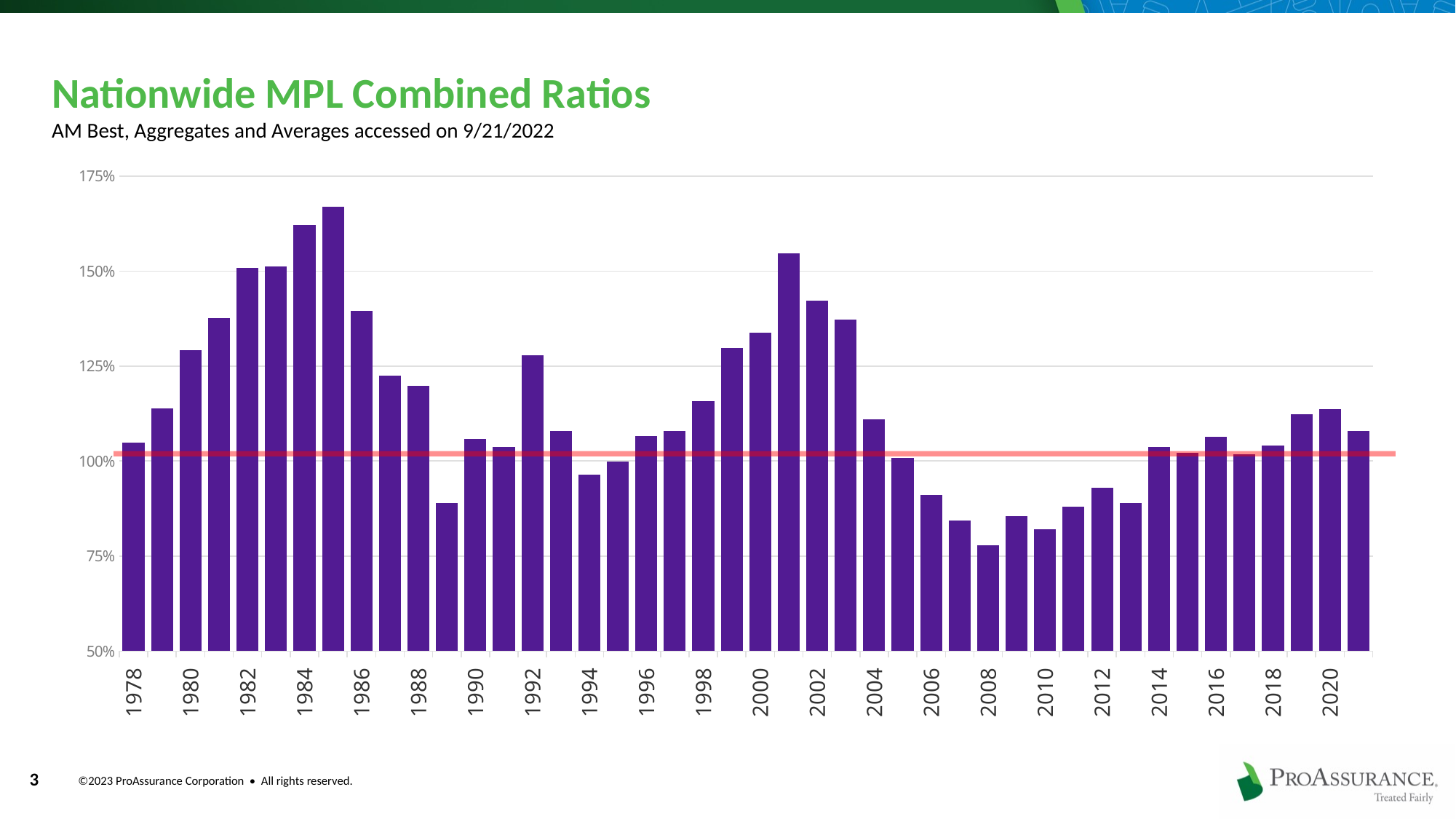
What is the title of the chart on the slide? Nationwide MPL Combined Ratios Is the value for 1989 greater or less than 100%? less Do the combined ratios rise or fall from 1985 to 1989? fall Which year has the lowest combined ratio in the chart? 2008 Is the value for 2001 greater or less than 150%? greater Is the value for 2008 greater or less than 100%? less Which year has the larger combined ratio, 1980 or 2008? 1980 Which year has the highest combined ratio in the chart? 1985 Which year has the larger combined ratio, 1985 or 2001? 1985 What is the first year shown on the x axis of the chart? 1978 What kind of chart is shown on the slide? Bar chart